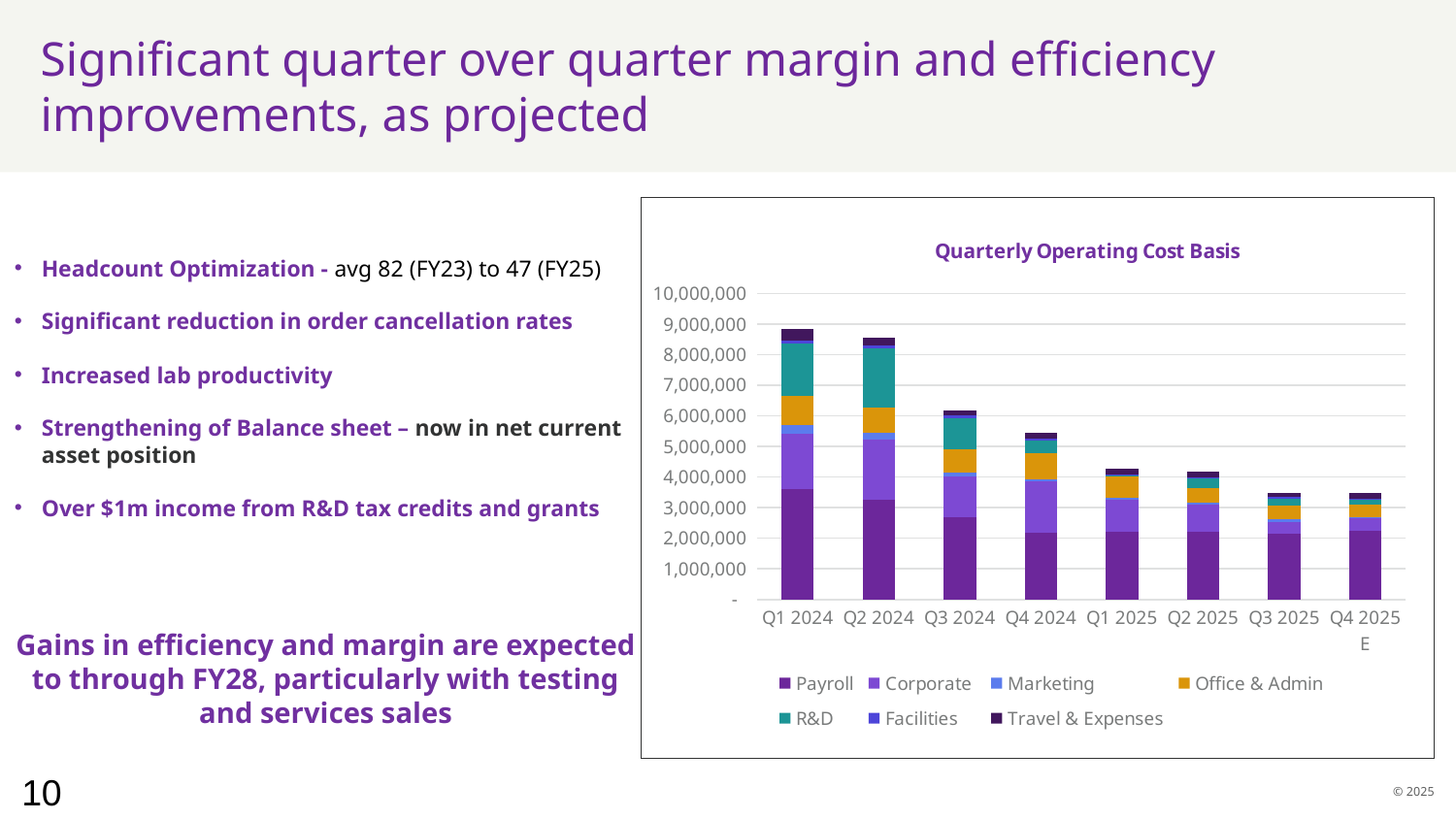
What is the title of the chart? Quarterly Operating Cost Basis Do the total quarterly operating costs rise or fall from Q1 2024 to Q4 2025 E? Fall Which quarter has the highest total operating cost in the chart? Q1 2024 What kind of chart is shown on the slide? Stacked bar chart Is the total operating cost for Q3 2025 greater or less than 4,000,000? less Which series forms the bottom segment of each stacked bar in the chart? Payroll How many series does the chart legend list? 7 Is the total operating cost for Q1 2024 greater or less than 8,000,000? greater Is the total operating cost for Q4 2024 greater or less than 6,000,000? less Which quarter has the larger total operating cost, Q2 2024 or Q3 2024? Q2 2024 How many quarters are shown along the x axis of the chart? 8